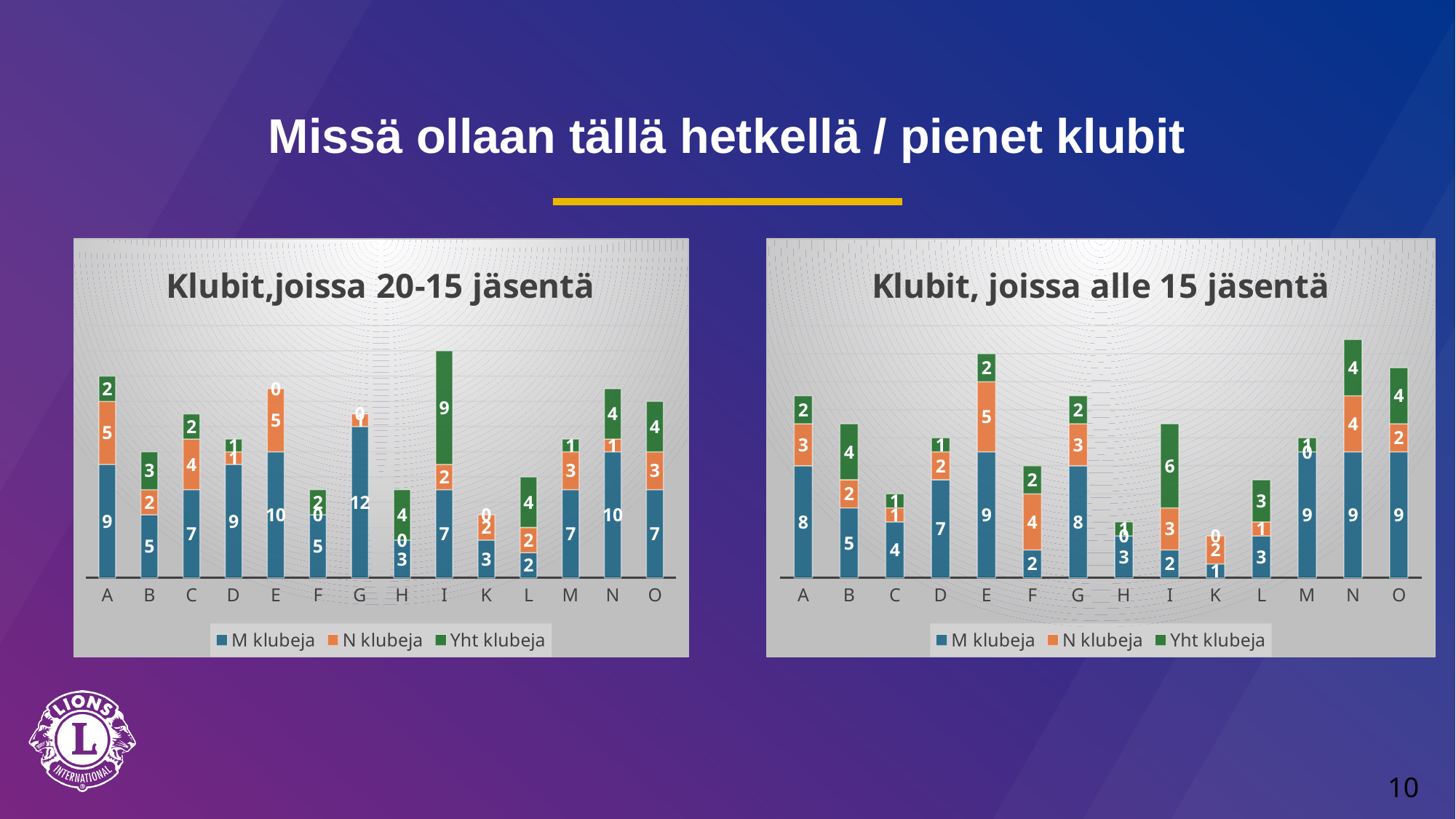
In the right chart 'Klubit, joissa alle 15 jäsentä', what is the total of the stacked bar for category N? 17 In the right chart 'Klubit, joissa alle 15 jäsentä', what is the difference between the M klubeja values for categories A and F? 6 In the right chart 'Klubit, joissa alle 15 jäsentä', what is the value of Yht klubeja for category I? 6 In the left chart 'Klubit,joissa 20-15 jäsentä', which category has the highest M klubeja value? G In the left chart 'Klubit,joissa 20-15 jäsentä', what is the value of M klubeja for category G? 12 How many series does the legend of the left chart 'Klubit,joissa 20-15 jäsentä' list? 3 What type of chart is the right chart 'Klubit, joissa alle 15 jäsentä'? Stacked bar chart In the left chart 'Klubit,joissa 20-15 jäsentä', what is the value of N klubeja for category A? 5 In the left chart 'Klubit,joissa 20-15 jäsentä', what is the value of Yht klubeja for category I? 9 In the left chart 'Klubit,joissa 20-15 jäsentä', what is the total of the stacked bar for category A? 16 In the right chart 'Klubit, joissa alle 15 jäsentä', which category has the lowest M klubeja value? K In the right chart 'Klubit, joissa alle 15 jäsentä', what is the value of N klubeja for category E? 5